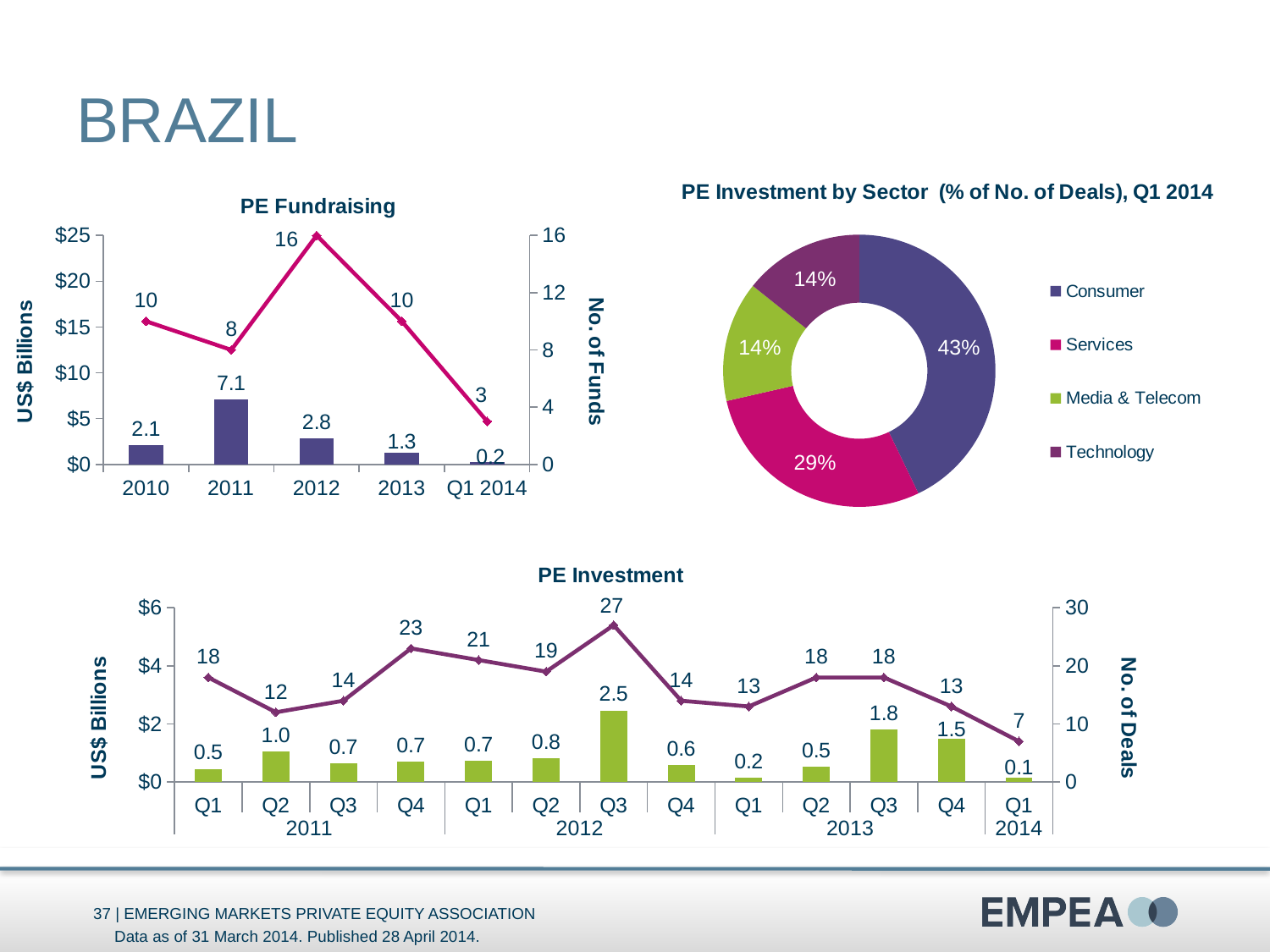
In the PE Investment chart, which is larger: the number of deals in Q4 2011 or in Q1 2012? Q4 2011 In the PE Fundraising chart, which year had the highest fundraising value in US$ billions? 2011 In the PE Investment by Sector chart, what share of deals was in Services? 29% In the PE Fundraising chart, what was the fundraising value in US$ billions for 2011? 7.1 In the PE Investment by Sector chart, which sector has the largest share of deals? Consumer In the PE Investment chart, which quarter had the highest number of deals? Q3 2012 In the PE Fundraising chart, how many categories are shown on the x axis? 5 In the PE Investment by Sector chart, how many sectors does the legend list? 4 In the PE Investment chart, what was the investment value in US$ billions for Q3 2012? 2.5 In the PE Fundraising chart, how many funds were raised in 2012? 16 In the PE Investment chart, what is the difference in number of deals between Q3 2013 and Q1 2014? 11 In the PE Fundraising chart, what is the difference in US$ billions between fundraising in 2012 and 2013? 1.5